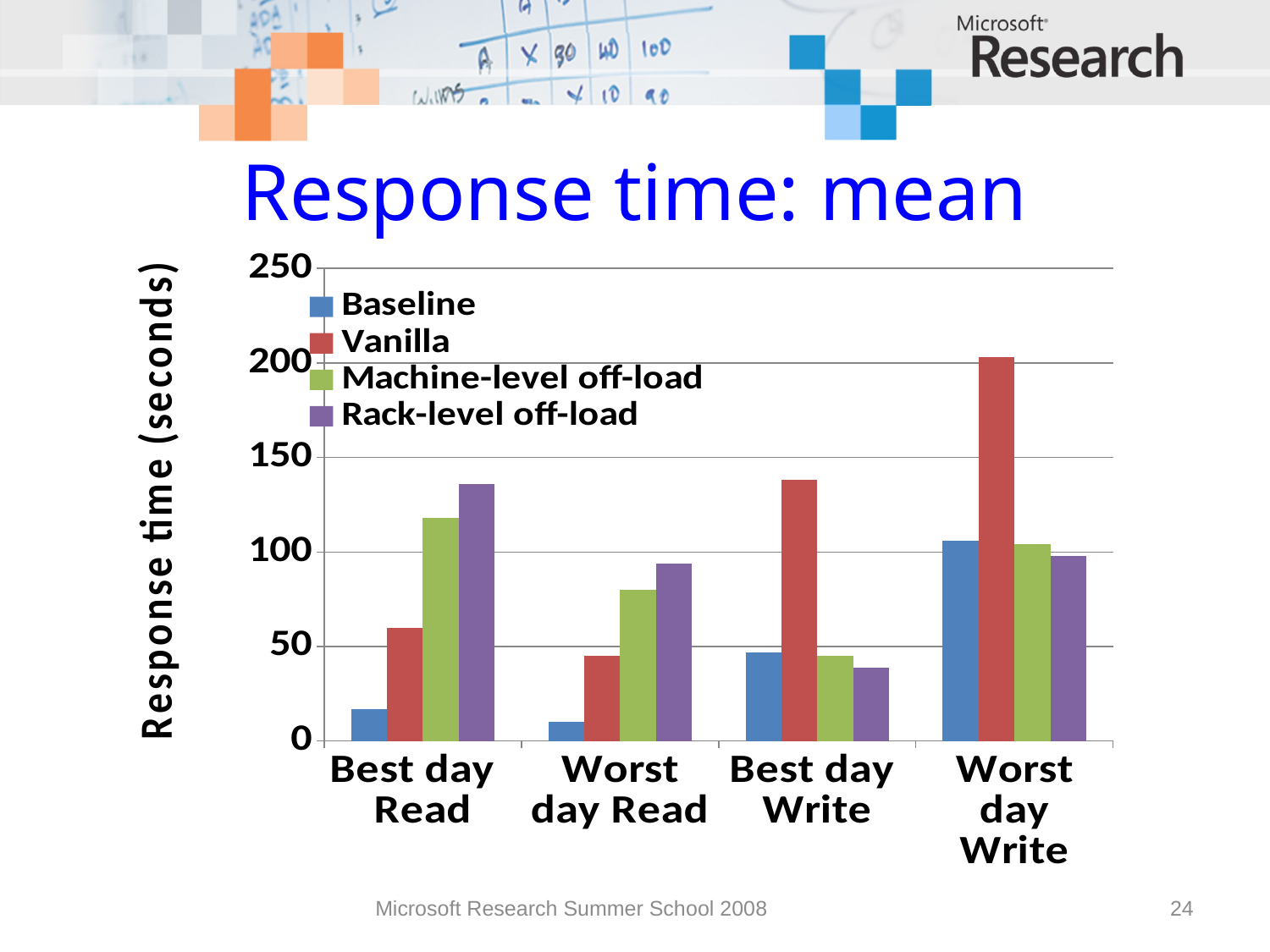
For Best day Read, which is larger: Rack-level off-load or Machine-level off-load? Rack-level off-load How many series does the legend list? 4 For which category is the Vanilla bar the highest? Worst day Write For Best day Write, which is larger: Vanilla or Baseline? Vanilla How many categories are shown on the x axis? 4 Is the Vanilla value for Worst day Write greater or less than 150? greater What is the label of the y axis? Response time (seconds) Which series has the highest value for Best day Read? Rack-level off-load Is the Rack-level off-load value for Worst day Read greater or less than 100? less Is the Baseline value for Best day Read greater or less than 50? less Which series has the lowest value for Worst day Read? Baseline What kind of chart is shown on the slide? bar chart